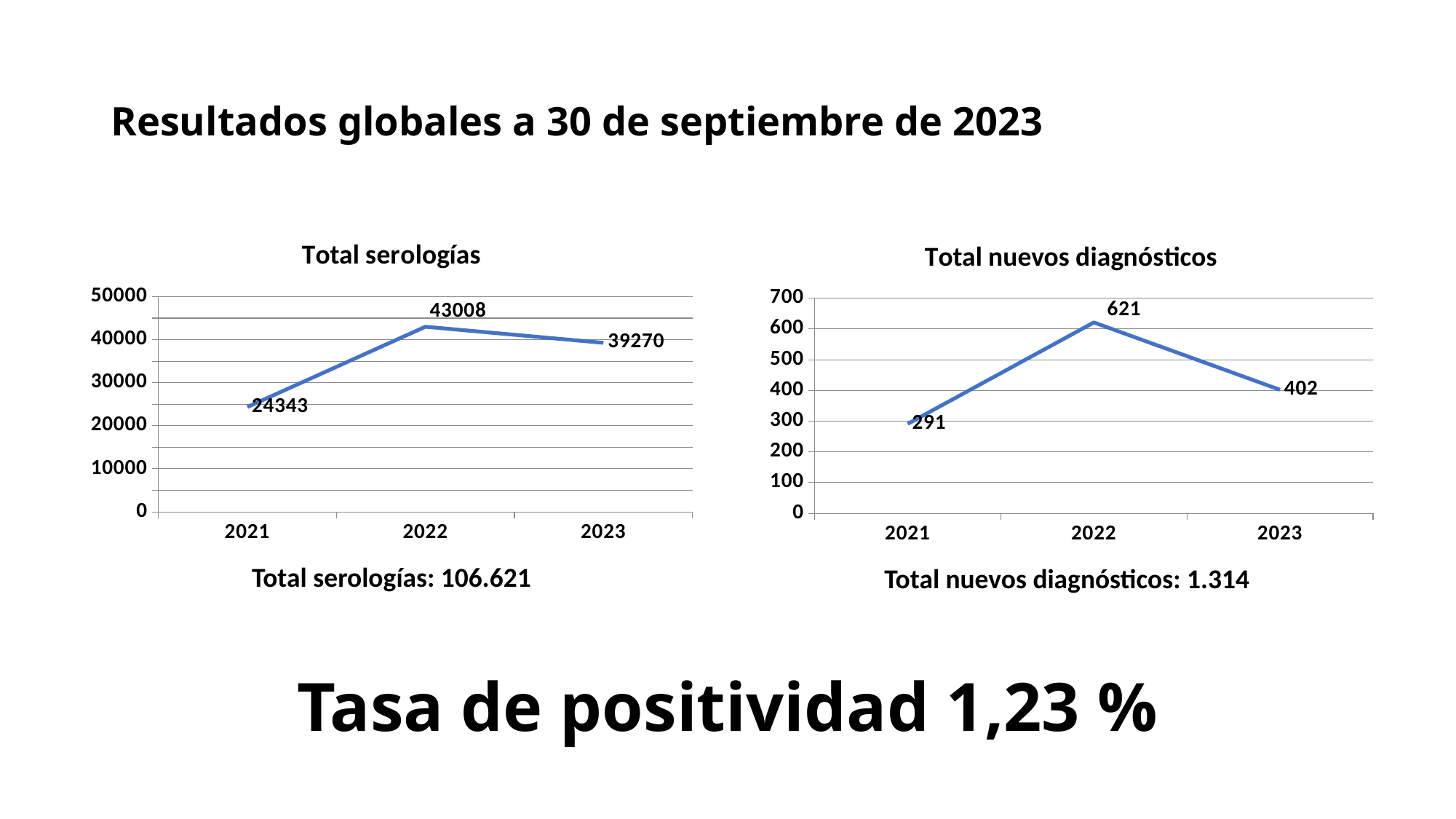
In the 'Total nuevos diagnósticos' chart, does the value rise or fall from 2022 to 2023? fall In the 'Total serologías' chart, what is the value for 2022? 43008 In the 'Total serologías' chart, is the value for 2023 greater or less than 40000? less In the 'Total serologías' chart, what is the value for 2021? 24343 How many years are plotted in the 'Total nuevos diagnósticos' chart? 3 In the 'Total serologías' chart, what is the difference between the 2022 and 2023 values? 3738 In the 'Total nuevos diagnósticos' chart, which is larger, the value for 2021 or the value for 2023? 2023 What kind of chart is the 'Total serologías' chart? line chart In the 'Total nuevos diagnósticos' chart, which year has the highest value? 2022 In the 'Total serologías' chart, which year has the lowest value? 2021 In the 'Total nuevos diagnósticos' chart, what is the value for 2023? 402 In the 'Total nuevos diagnósticos' chart, what is the difference between the 2022 and 2021 values? 330